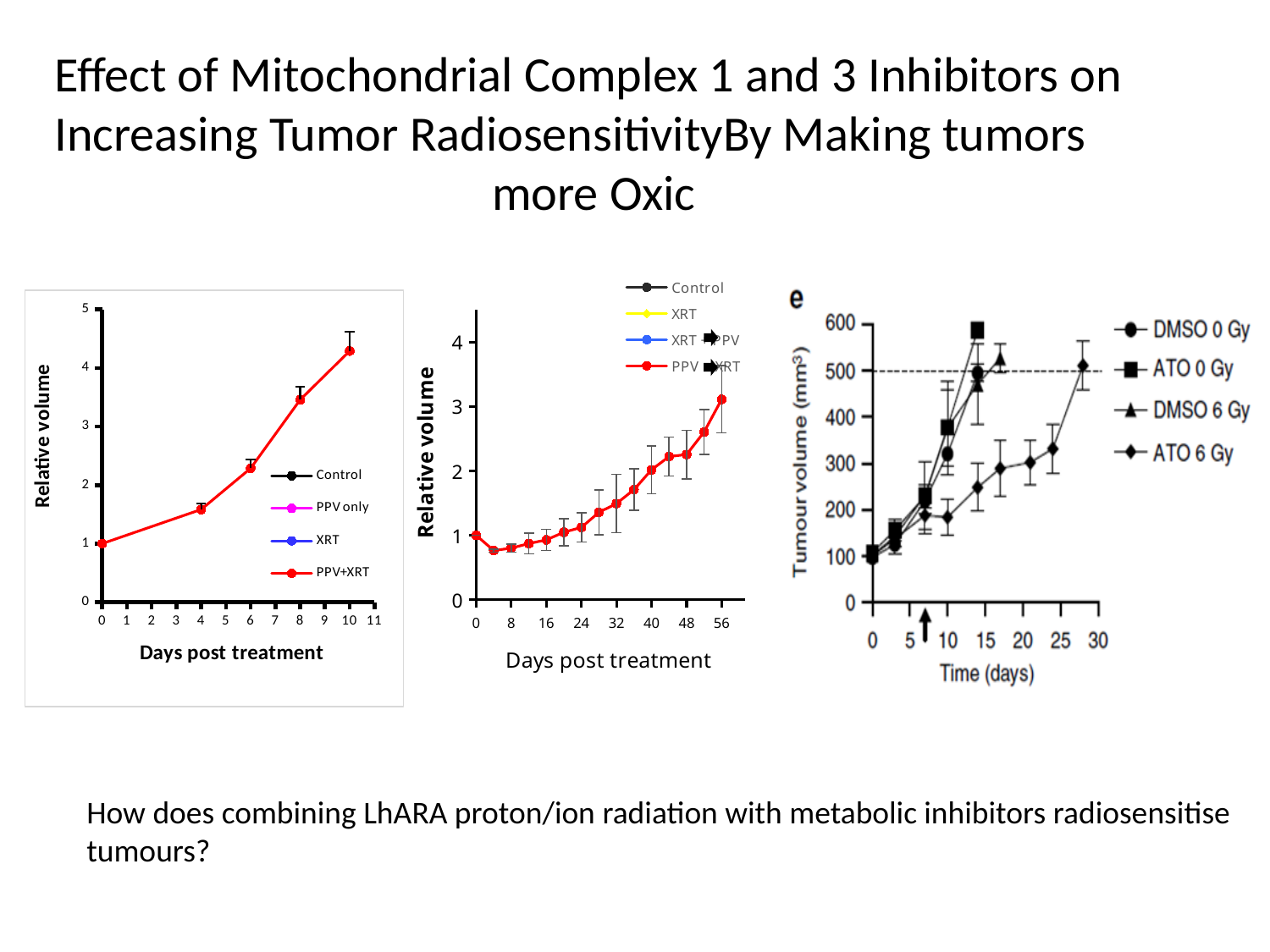
What is the y-axis title of the right chart (panel e)? Tumour volume (mm³) In the left chart, does the plotted relative volume rise or fall as days post treatment increase? rise In the left chart, is the relative volume at day 4 greater or less than 2? less How many series does the legend of the left chart list? 4 In the left chart, what is the relative volume at day 0? 1 In the right chart (panel e), how many series does the legend list? 4 What kind of chart is the left chart with the 'Days post treatment' x axis running from 0 to 11? line chart In the middle chart, is the relative volume at day 48 greater or less than 3? less In the left chart, is the relative volume at day 10 greater or less than 4? greater How many series does the legend of the middle chart (x axis 0 to 56 days) list? 4 In the right chart (panel e), at day 14, which is larger: the tumour volume for ATO 0 Gy or for ATO 6 Gy? ATO 0 Gy